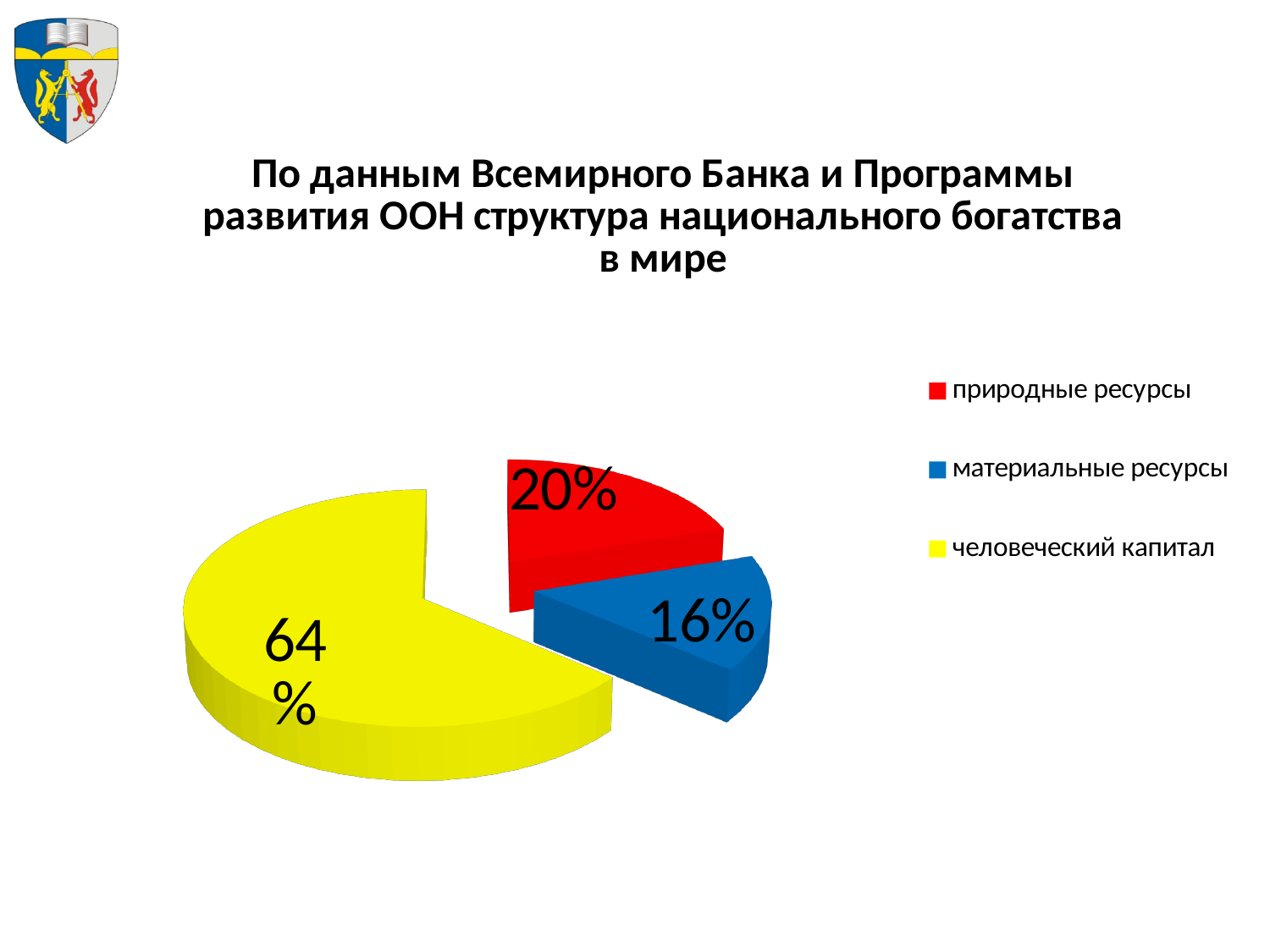
Which is larger, the slice for природные ресурсы or the slice for материальные ресурсы? природные ресурсы What colour is the slice for человеческий капитал? yellow What share of the pie does человеческий капитал have? 64% What share of the pie does природные ресурсы have? 20% Which category has the largest slice of the pie? человеческий капитал Which category has the smallest slice of the pie? материальные ресурсы What kind of chart is shown on the slide? pie chart What is the difference in percentage points between человеческий капитал and природные ресурсы? 44 What share of the pie does материальные ресурсы have? 16% Which category is shown in blue in the legend? материальные ресурсы What is the difference in percentage points between природные ресурсы and материальные ресурсы? 4 How many categories does the pie chart show? 3